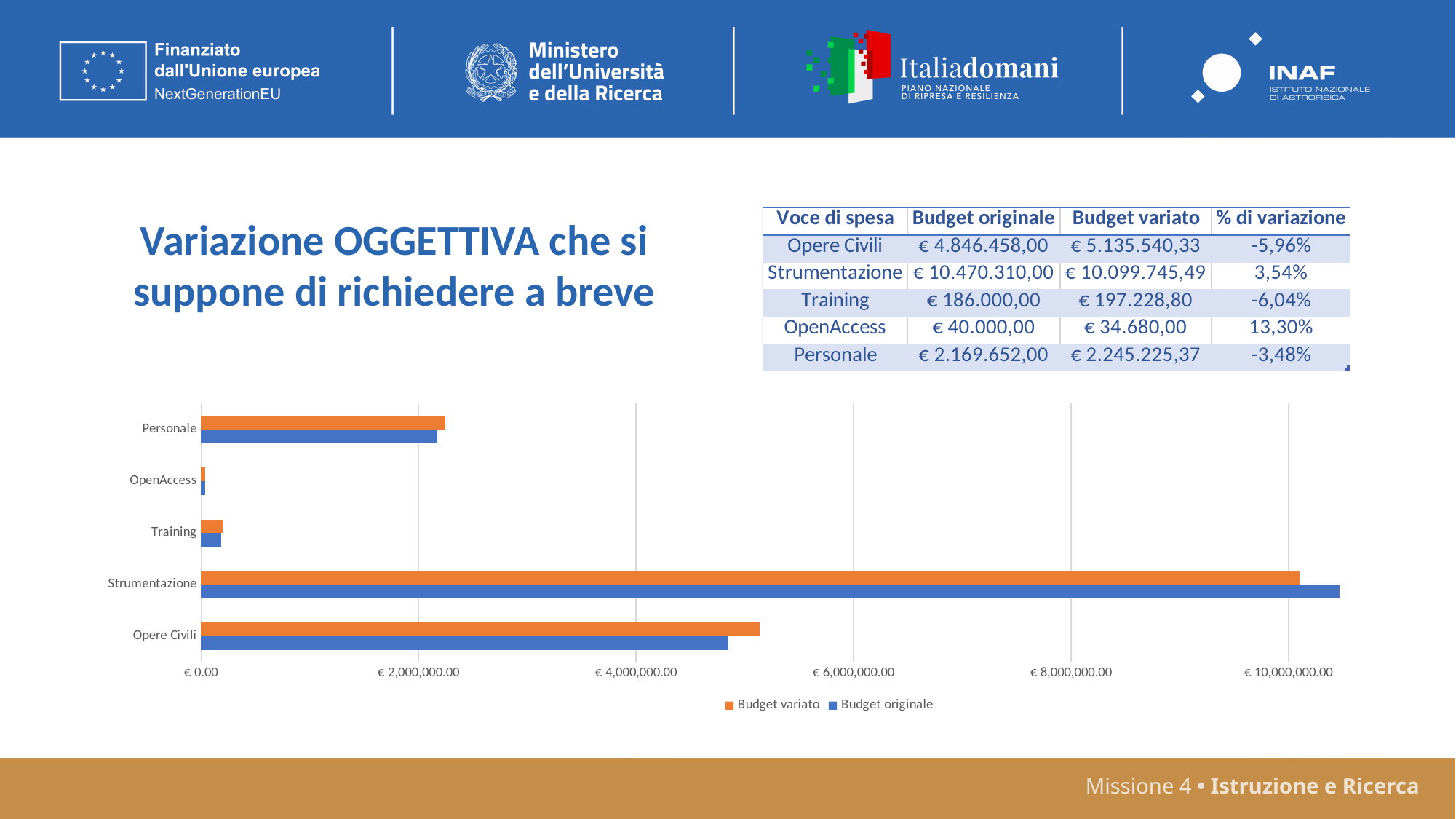
What colour represents the Budget variato series in the chart? orange According to the table on the slide, what is the Budget originale for OpenAccess? € 40.000,00 Is the Budget originale value for Personale greater or less than € 4,000,000.00? less Which category has the lowest Budget variato in the chart? OpenAccess What kind of chart is shown on the slide? bar chart Is the Budget variato value for Opere Civili greater or less than € 4,000,000.00? greater Is the Budget originale value for Strumentazione greater or less than € 10,000,000.00? greater How many categories are plotted on the chart? 5 How many series does the chart legend list? 2 Which category has the highest Budget originale in the chart? Strumentazione For Opere Civili, which is larger: Budget originale or Budget variato? Budget variato For Strumentazione, which is larger: Budget originale or Budget variato? Budget originale